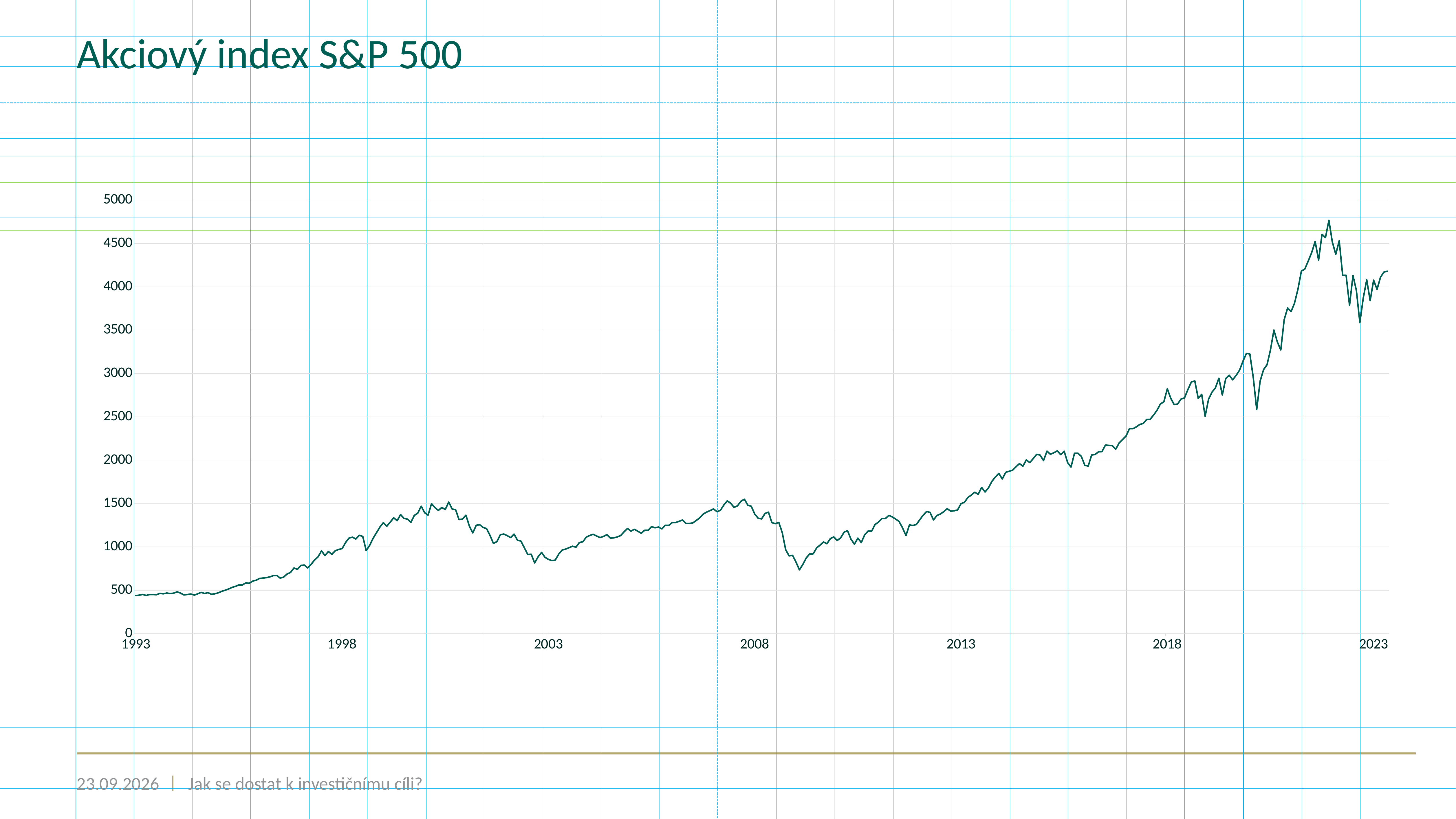
Is the value of the index at the start of 2023 greater or less than 3500? greater How many year labels are shown on the x axis? 7 Is the value of the index at the start of 2008 greater or less than 1000? greater Is the value of the index at the start of 2018 greater or less than 2500? greater What kind of chart is shown on the slide? line chart What is the highest value shown on the y axis? 5000 What is the title of the chart? Akciový index S&P 500 Which is larger, the index value at the start of 2018 or at the start of 2008? 2018 Overall, does the S&P 500 index rise or fall from 1993 to 2023? rise